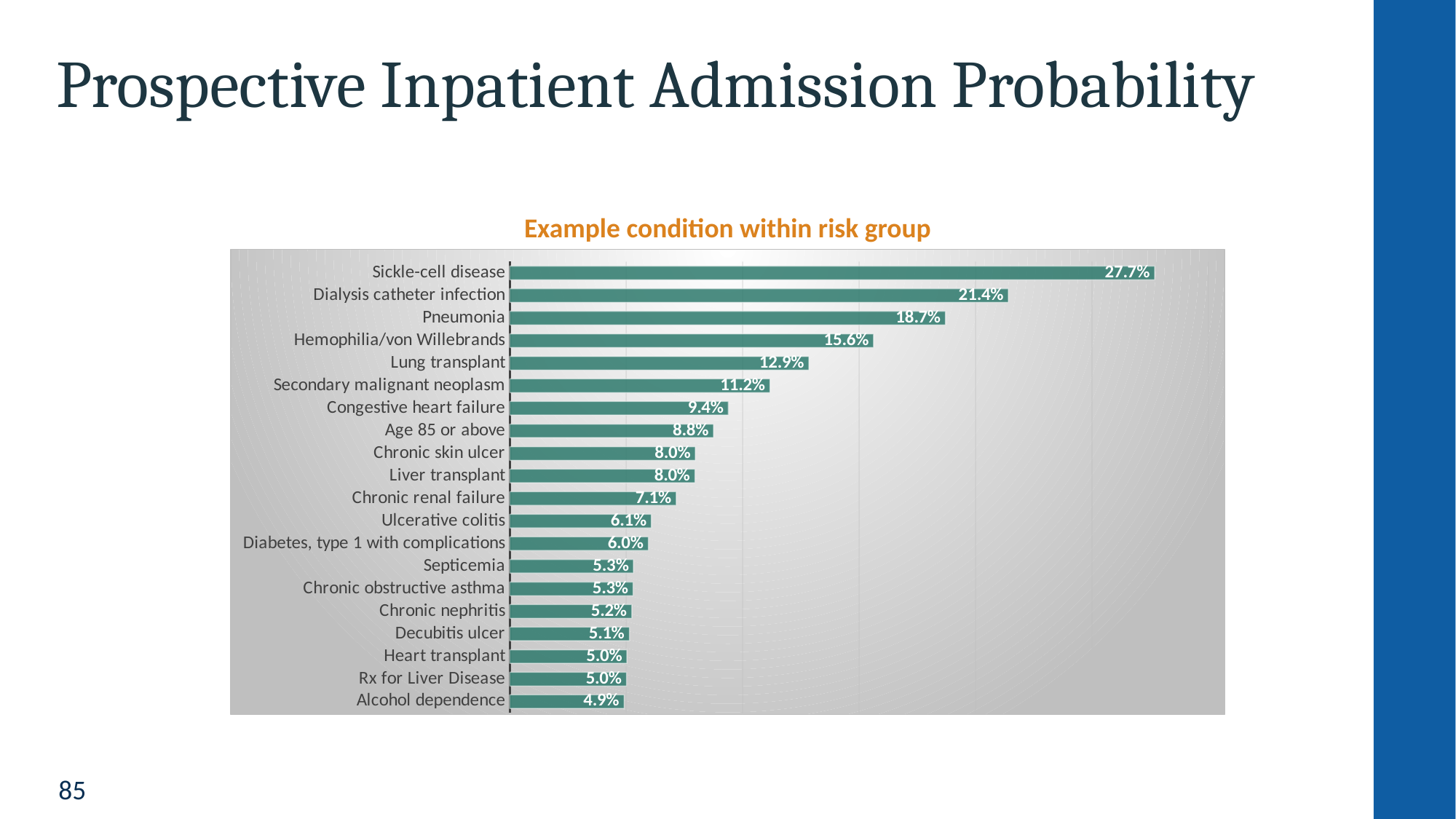
Which has a larger value, Hemophilia/von Willebrands or Lung transplant? Hemophilia/von Willebrands Which condition has the lowest value? Alcohol dependence Which condition has the highest value? Sickle-cell disease What is the difference between the values for Lung transplant and Secondary malignant neoplasm? 1.7% What is the value for Sickle-cell disease? 27.7% How many conditions are shown in the chart? 20 What is the value for Congestive heart failure? 9.4% What is the value for Chronic nephritis? 5.2% What kind of chart is shown on the slide? Bar chart What is the difference between the values for Sickle-cell disease and Dialysis catheter infection? 6.3% What is the value for Pneumonia? 18.7% What is the title of the chart? Example condition within risk group